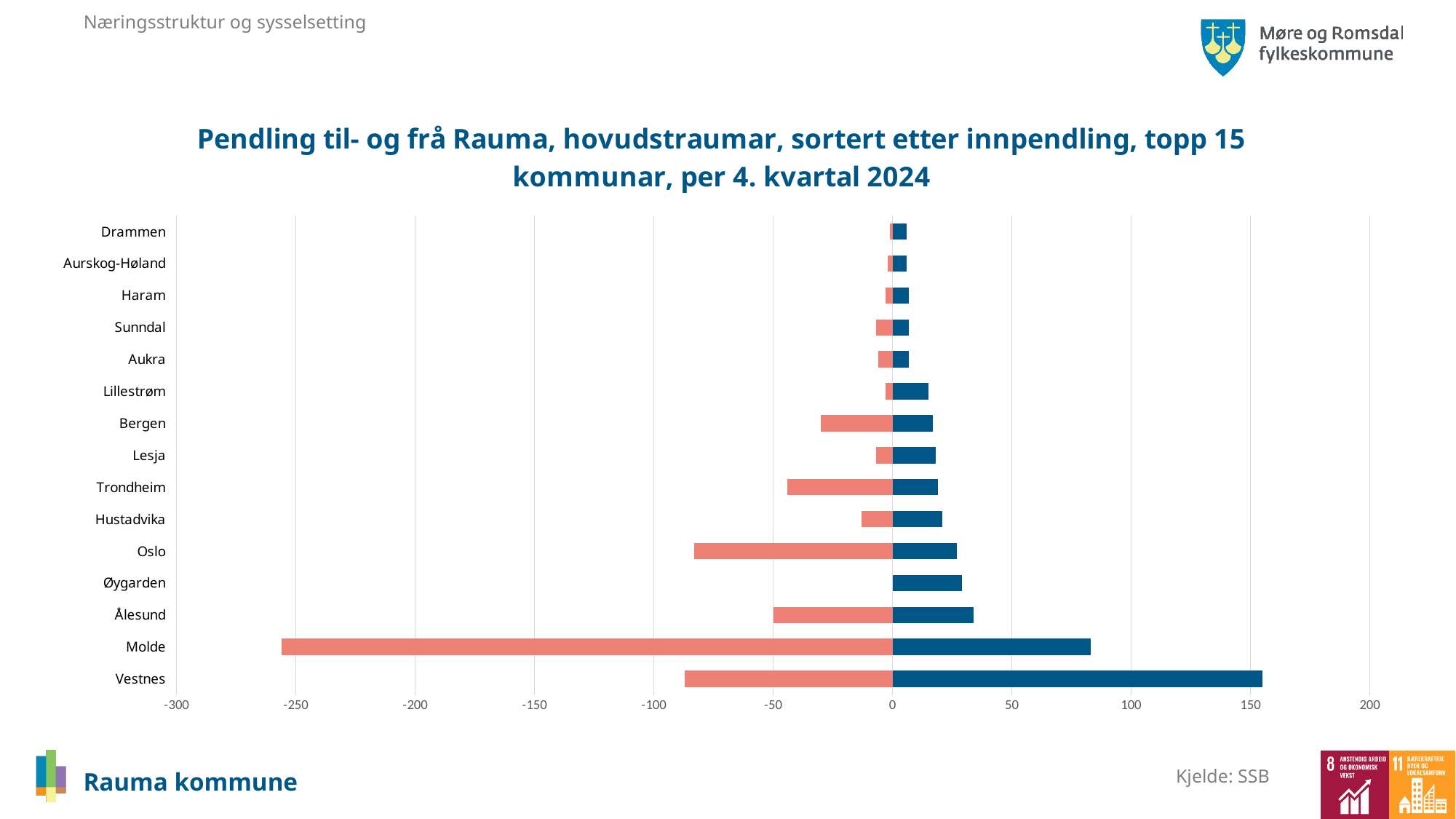
Is the red bar value for Molde greater or less than -200? less Is the blue bar value for Vestnes greater or less than 100? greater Is the blue bar value for Molde greater or less than 100? less Which municipality has a blue bar but no red bar? Øygarden Which municipality has the longest blue (positive) bar? Vestnes How many municipalities are listed on the vertical axis of the chart? 15 What kind of chart is shown on the slide? bar chart Which has the larger blue bar, Molde or Ålesund? Molde What source is cited for the chart data? SSB Which municipality has the longest red (negative) bar? Molde